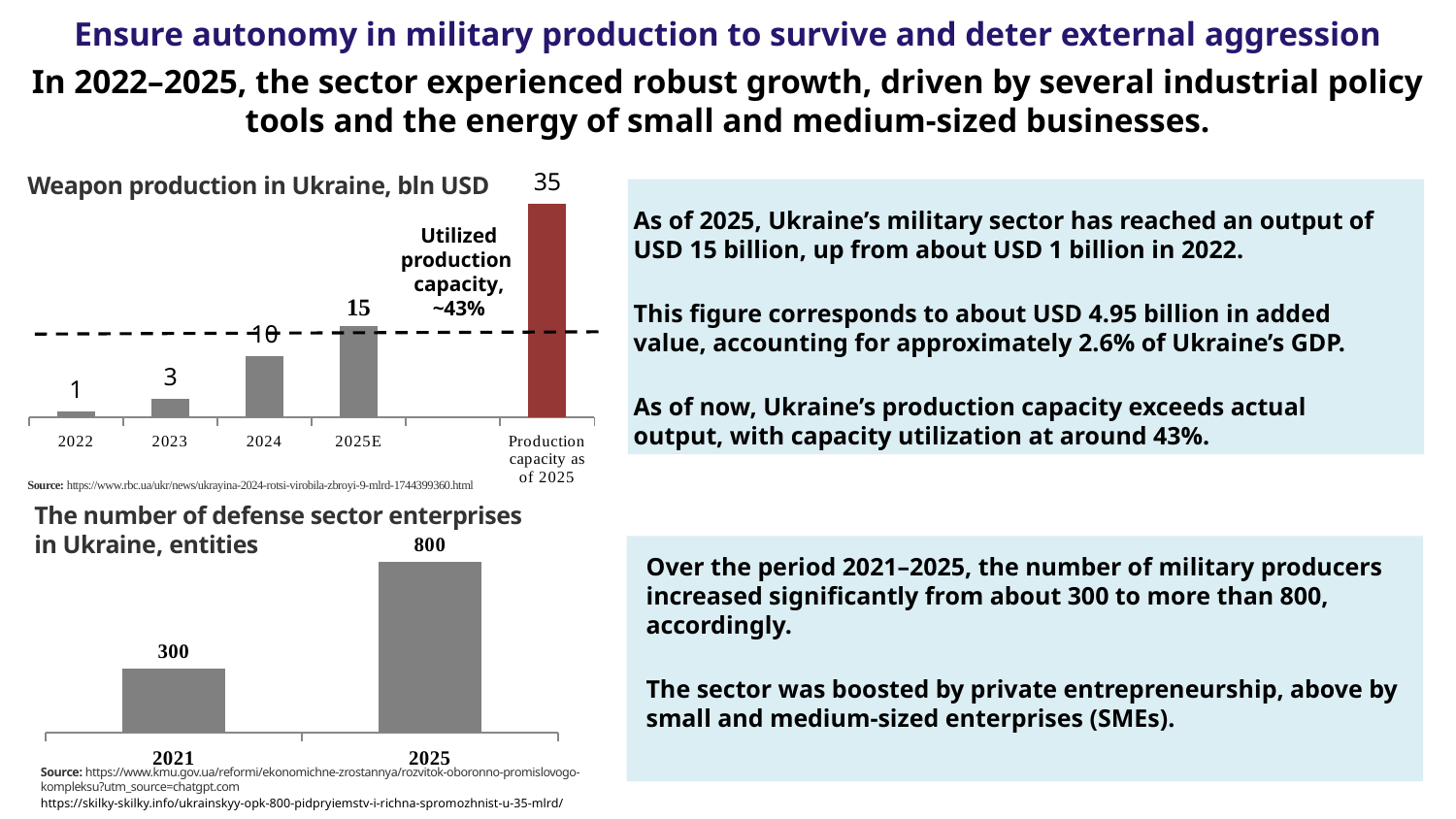
In the 'Weapon production in Ukraine, bln USD' chart, what is the difference between the 2025E value and the 2024 value? 5 In the 'The number of defense sector enterprises in Ukraine, entities' chart, what is the value for 2021? 300 What type of chart is 'The number of defense sector enterprises in Ukraine, entities'? bar chart In the 'Weapon production in Ukraine, bln USD' chart, how many bars are plotted? 5 In the 'The number of defense sector enterprises in Ukraine, entities' chart, what is the difference between the 2025 and 2021 values? 500 In the 'Weapon production in Ukraine, bln USD' chart, do the values rise or fall from 2022 to 2025E? rise In the 'Weapon production in Ukraine, bln USD' chart, which category has the highest value? Production capacity as of 2025 In the 'Weapon production in Ukraine, bln USD' chart, what utilized production capacity percentage is annotated? ~43% In the 'Weapon production in Ukraine, bln USD' chart, which category has the lowest value? 2022 In the 'Weapon production in Ukraine, bln USD' chart, what is the value for 2025E? 15 In the 'Weapon production in Ukraine, bln USD' chart, what is the value of the 'Production capacity as of 2025' bar? 35 In the 'Weapon production in Ukraine, bln USD' chart, what is the value for 2023? 3